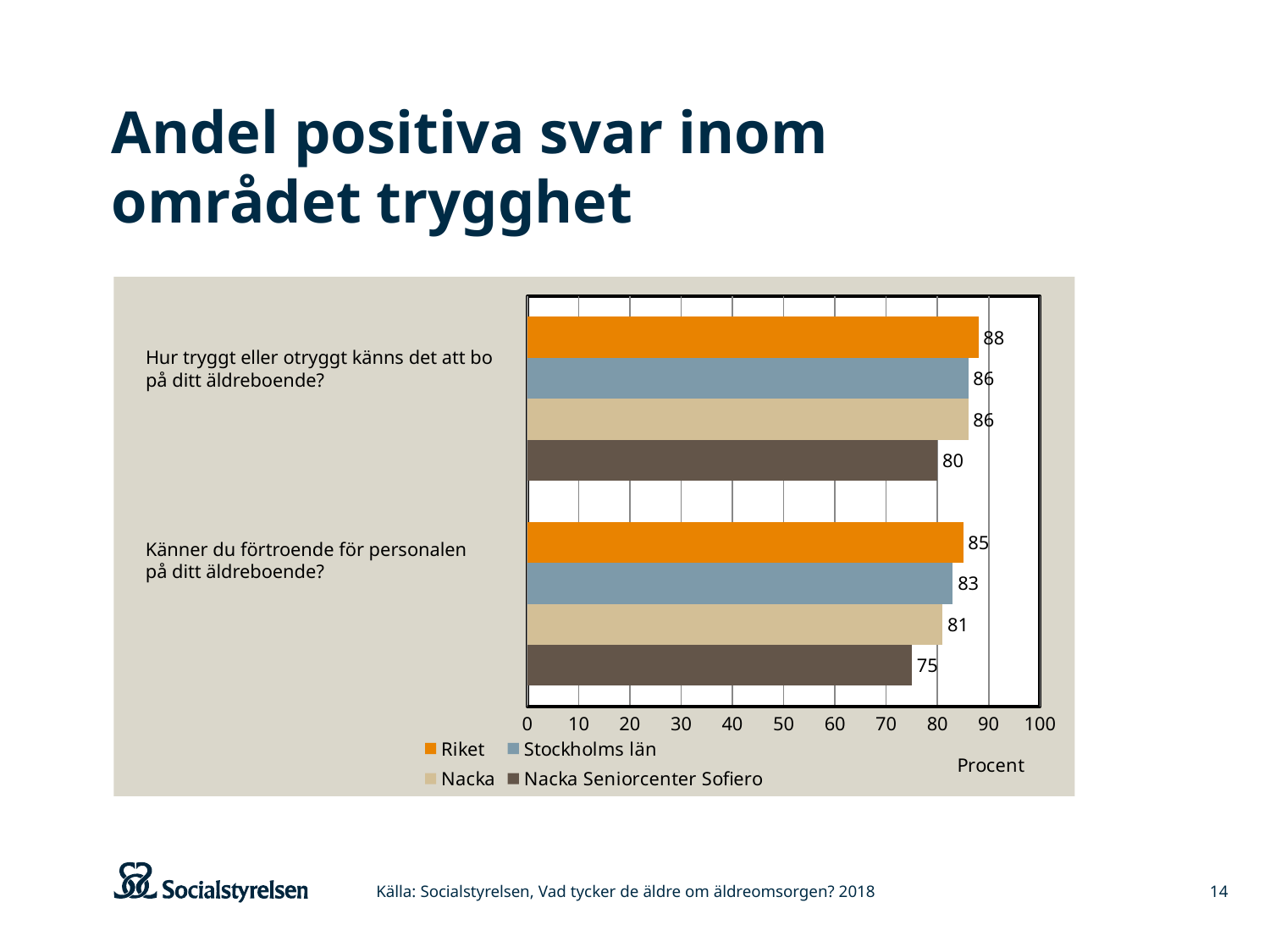
What is the label on the horizontal axis of the chart? Procent Which is larger: Nacka on "Hur tryggt eller otryggt känns det att bo på ditt äldreboende?" or Nacka on "Känner du förtroende för personalen på ditt äldreboende?"? Hur tryggt eller otryggt känns det att bo på ditt äldreboende? What kind of chart is shown on the slide? Bar chart How many series does the legend list? 4 Which series has the lowest value on the question "Känner du förtroende för personalen på ditt äldreboende?"? Nacka Seniorcenter Sofiero Which series has the highest value on the question "Hur tryggt eller otryggt känns det att bo på ditt äldreboende?"? Riket What is the difference between Riket and Nacka Seniorcenter Sofiero on the question "Känner du förtroende för personalen på ditt äldreboende?"? 10 What is the value for Nacka on the question "Hur tryggt eller otryggt känns det att bo på ditt äldreboende?"? 86 What is the difference between Riket and Nacka Seniorcenter Sofiero on the question "Hur tryggt eller otryggt känns det att bo på ditt äldreboende?"? 8 What is the value for Nacka Seniorcenter Sofiero on the question "Känner du förtroende för personalen på ditt äldreboende?"? 75 What is the value for Stockholms län on the question "Känner du förtroende för personalen på ditt äldreboende?"? 83 What is the value for Riket on the question "Hur tryggt eller otryggt känns det att bo på ditt äldreboende?"? 88